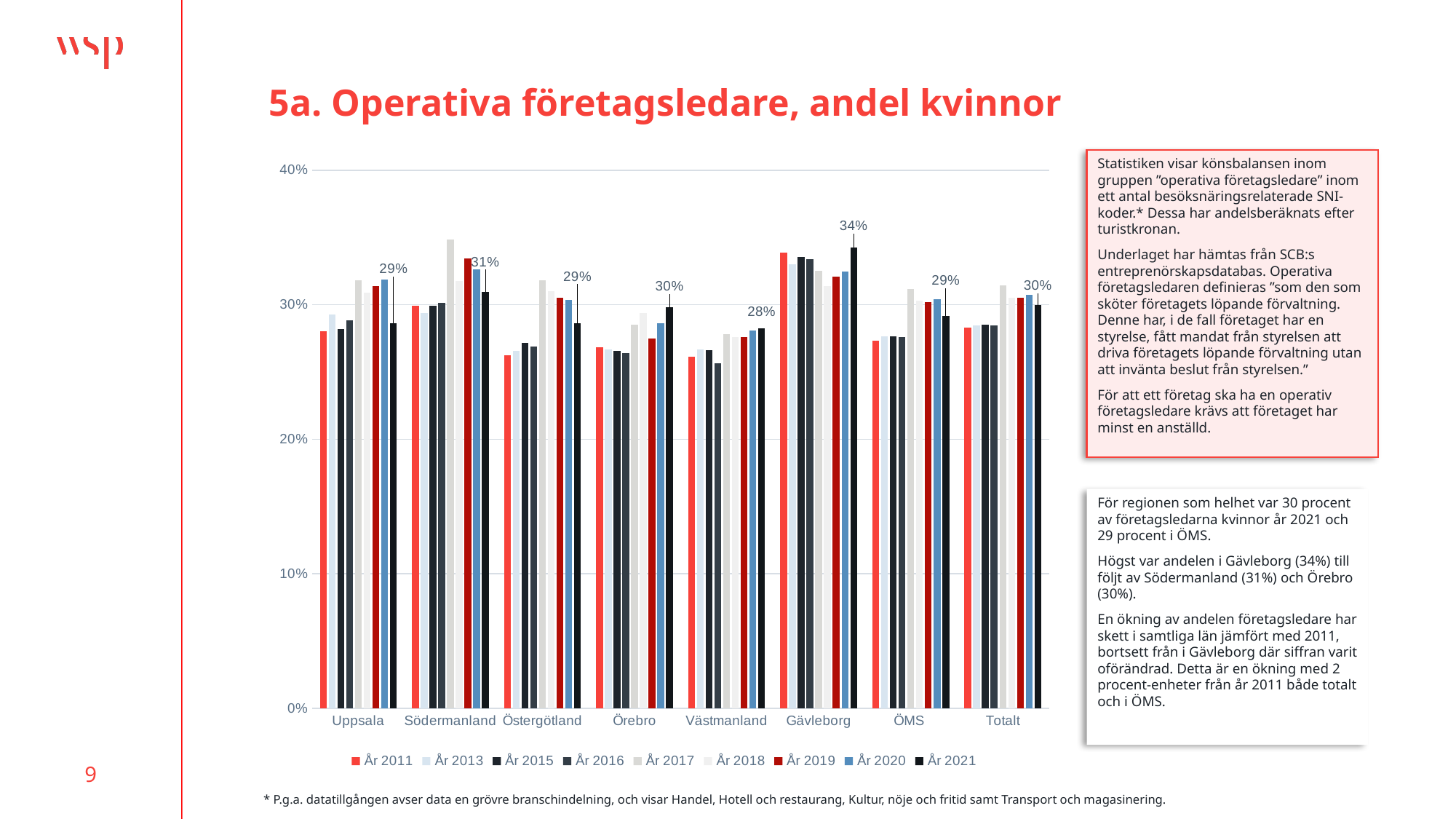
What kind of chart is shown on the slide? Bar chart Which is larger for År 2021: Södermanland or Örebro? Södermanland Which category has the highest value for År 2021? Gävleborg Is the value for År 2011 in Uppsala greater or less than 30%? less What is the value for År 2021 for Totalt? 30% How many categories are shown on the x axis? 8 Which category has the lowest value for År 2021? Västmanland What is the difference between the År 2021 values for Gävleborg and Västmanland? 6 percentage points Is the value for År 2011 in Gävleborg greater or less than 30%? greater What is the value for År 2021 in Västmanland? 28% How many series does the legend list? 9 What is the value for År 2021 in Gävleborg? 34%